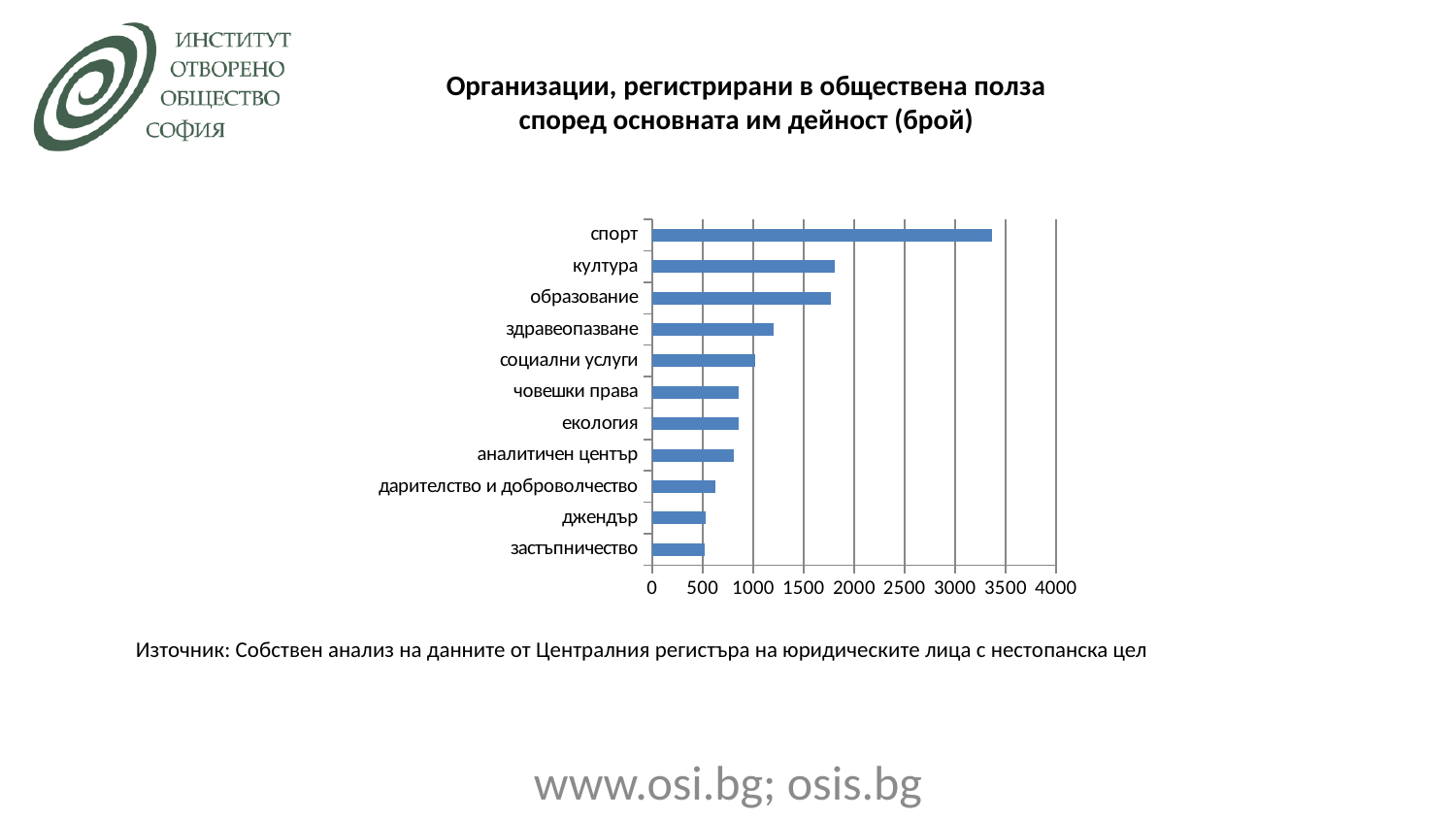
What kind of chart is shown on the slide? bar chart Is the value for човешки права greater or less than 1000? less What is the title of the chart? Организации, регистрирани в обществена полза според основната им дейност (брой) Which is larger, the value for здравеопазване or the value for социални услуги? здравеопазване Is the value for аналитичен център greater or less than 500? greater Is the value for спорт greater or less than 3000? greater Which is larger, the value for спорт or the value for култура? спорт How many categories are plotted in the chart? 11 Which category has the highest value? спорт